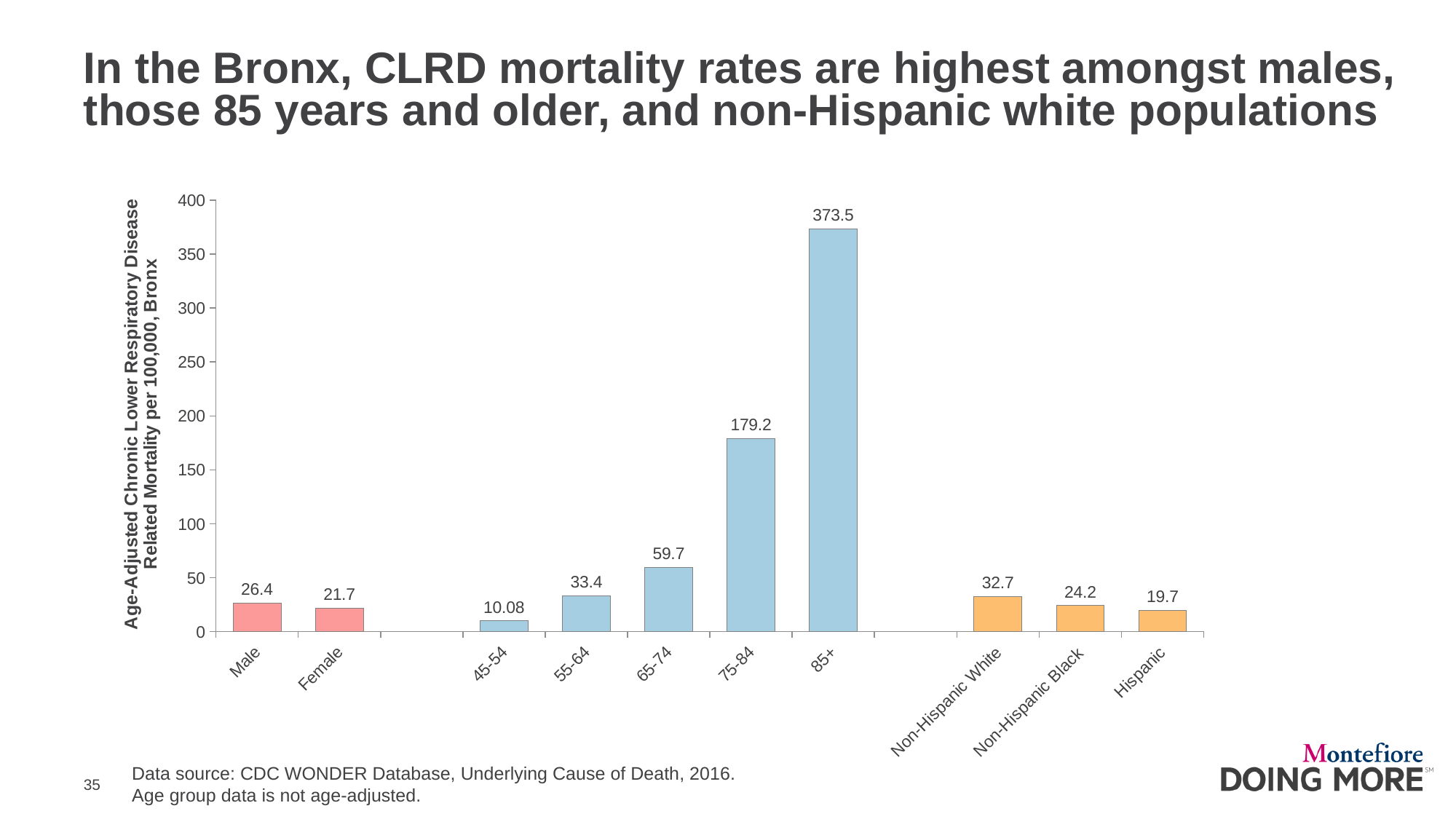
What kind of chart is shown on the slide? Bar chart Which has a higher CLRD mortality rate, Non-Hispanic White or Hispanic? Non-Hispanic White What is the CLRD mortality rate for the 45-54 age group? 10.08 What is the CLRD mortality rate for the Non-Hispanic Black population? 24.2 How many categories are plotted on the chart? 10 What is the CLRD mortality rate for males? 26.4 Which category has the highest CLRD mortality rate? 85+ Is the CLRD mortality rate for the 75-84 age group greater or less than 150? greater What is the difference between the CLRD mortality rates for the 85+ and 75-84 age groups? 194.3 What is the difference between the CLRD mortality rates for males and females? 4.7 Which category has the lowest CLRD mortality rate? 45-54 What is the CLRD mortality rate for the 85+ age group? 373.5